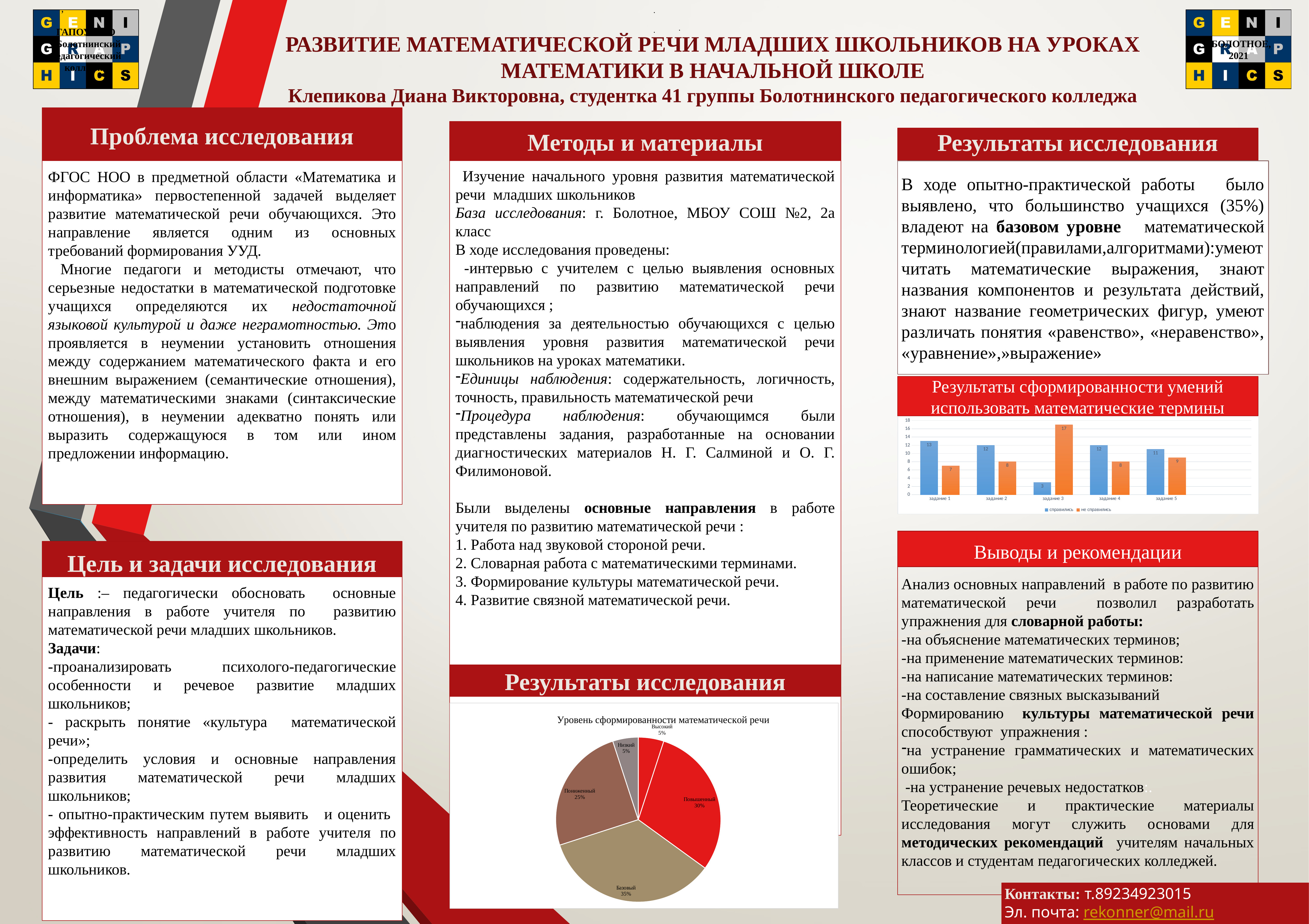
In the bar chart titled «Результаты сформированности умений использовать математические термины», how many series does the legend list? 2 In the bar chart titled «Результаты сформированности умений использовать математические термины», what is the value for «не справились» for задание 3? 17 In the pie chart titled «Уровень сформированности математической речи», what is the difference between the shares of «Повышенный» and «Пониженный»? 5% In the pie chart titled «Уровень сформированности математической речи», how many slices are there? 5 In the bar chart titled «Результаты сформированности умений использовать математические термины», what is the difference between «не справились» and «справились» for задание 3? 14 What kind of chart is the one titled «Результаты сформированности умений использовать математические термины»? bar chart In the pie chart titled «Уровень сформированности математической речи», which level has the largest share? Базовый In the bar chart titled «Результаты сформированности умений использовать математические термины», what is the value for «справились» for задание 1? 13 In the bar chart titled «Результаты сформированности умений использовать математические термины», which is larger for задание 5: «справились» or «не справились»? справились In the bar chart titled «Результаты сформированности умений использовать математические термины», how many categories are shown on the x axis? 5 In the bar chart titled «Результаты сформированности умений использовать математические термины», which задание has the lowest value for «справились»? задание 3 In the pie chart titled «Уровень сформированности математической речи», what share does «Базовый» have? 35%